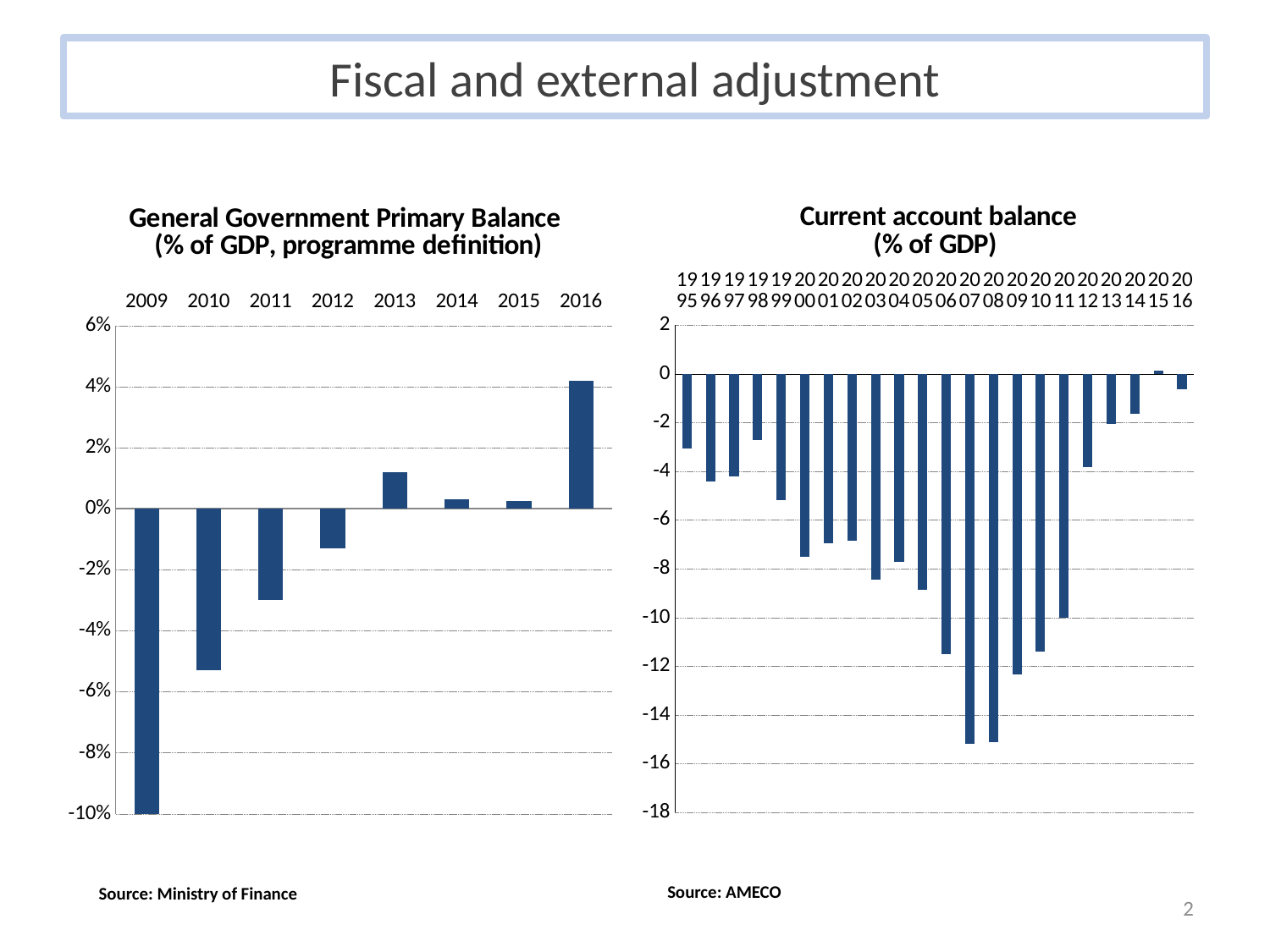
On the General Government Primary Balance chart, which year has the lowest value? 2009 On the Current account balance chart, which is larger, the value for 2006 or the value for 2012? 2012 On the General Government Primary Balance chart, which is larger, the value for 2010 or the value for 2011? 2011 On the Current account balance chart, is the value for 2007 greater or less than -14? less On the General Government Primary Balance chart, is the value for 2010 greater or less than -4%? less On the General Government Primary Balance chart, which year has the highest value? 2016 On the General Government Primary Balance chart, is the value for 2016 greater or less than 4%? greater On the Current account balance chart, which year has the highest value? 2015 How many years are shown on the Current account balance chart? 22 How many years are shown on the General Government Primary Balance chart? 8 What kind of chart is the Current account balance chart? bar chart